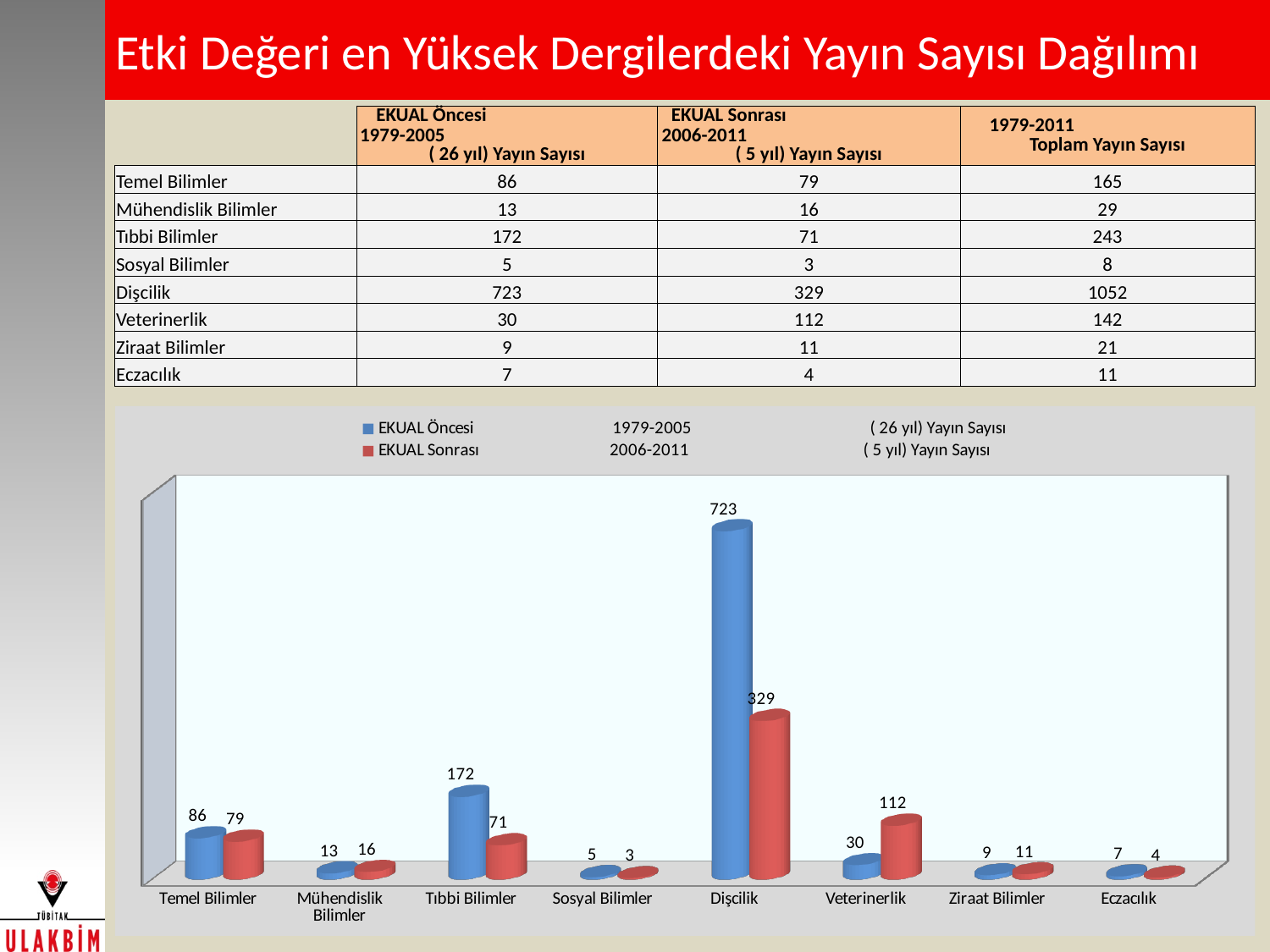
Which category has the lowest EKUAL Sonrası value in the chart? Sosyal Bilimler What is the EKUAL Öncesi value for Dişçilik in the chart? 723 How many series does the chart legend list? 2 What is the difference between the EKUAL Öncesi values for Temel Bilimler and Veterinerlik? 56 What is the EKUAL Öncesi value for Tıbbi Bilimler in the chart? 172 Which colour represents the EKUAL Sonrası series in the chart? red What type of chart is shown on the slide? bar chart Which category has the highest EKUAL Sonrası value in the chart? Dişcilik What is the EKUAL Sonrası value for Veterinerlik in the chart? 112 For Veterinerlik, which is larger: the EKUAL Öncesi value or the EKUAL Sonrası value? EKUAL Sonrası How many categories are shown on the x axis of the chart? 8 What is the difference between the EKUAL Öncesi and EKUAL Sonrası values for Dişçilik? 394